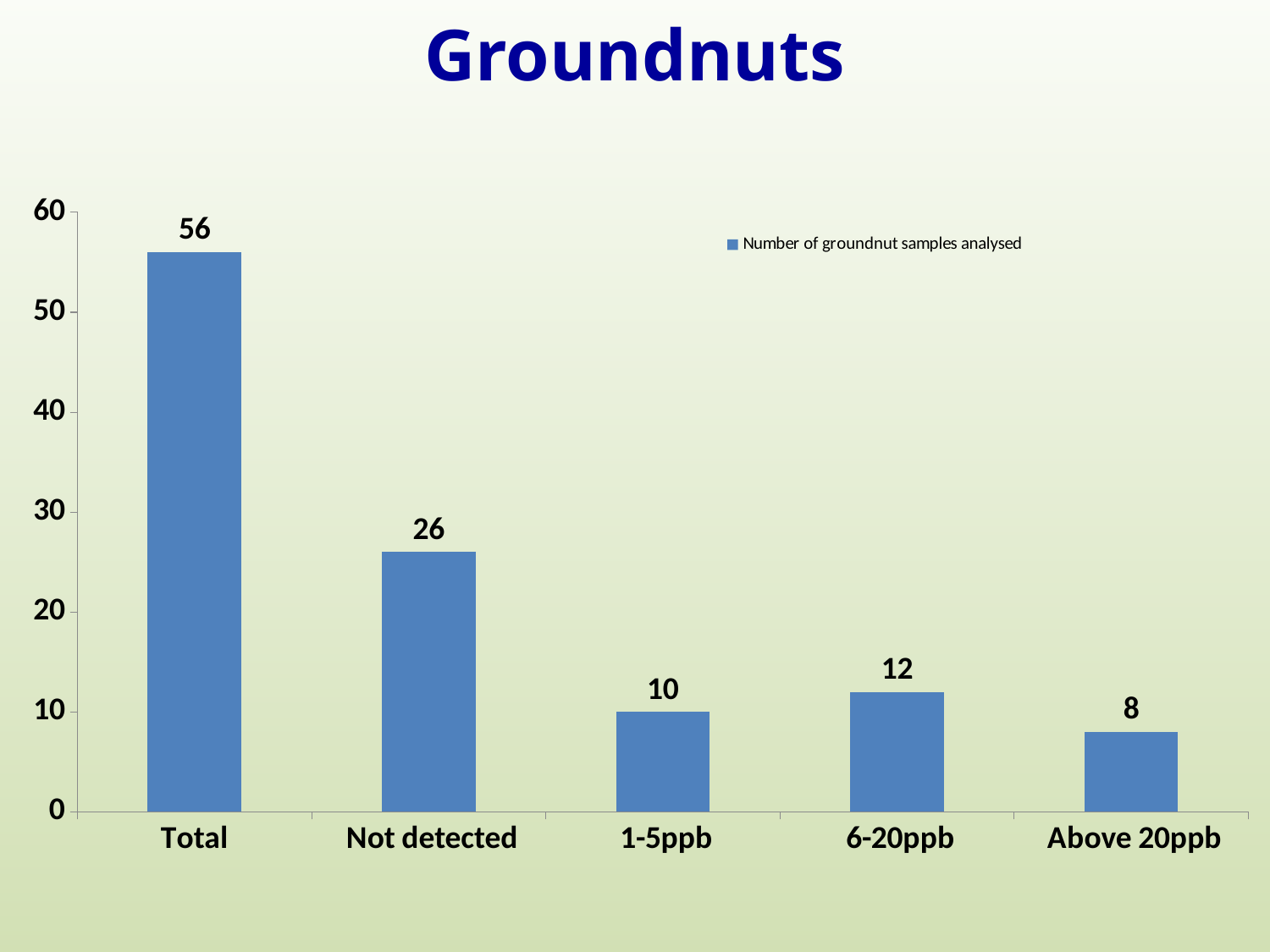
What is the value for Above 20ppb? 8 Which is larger, the value for 1-5ppb or the value for 6-20ppb? 6-20ppb What series name does the legend show? Number of groundnut samples analysed What is the value for 1-5ppb? 10 What is the difference between the values for 6-20ppb and Above 20ppb? 4 What kind of chart is shown on the slide? Bar chart Which category has the highest value? Total What is the difference between the values for Total and Not detected? 30 Which category has the lowest value? Above 20ppb What is the value for Not detected? 26 What is the value for Total? 56 How many categories are shown on the x axis? 5